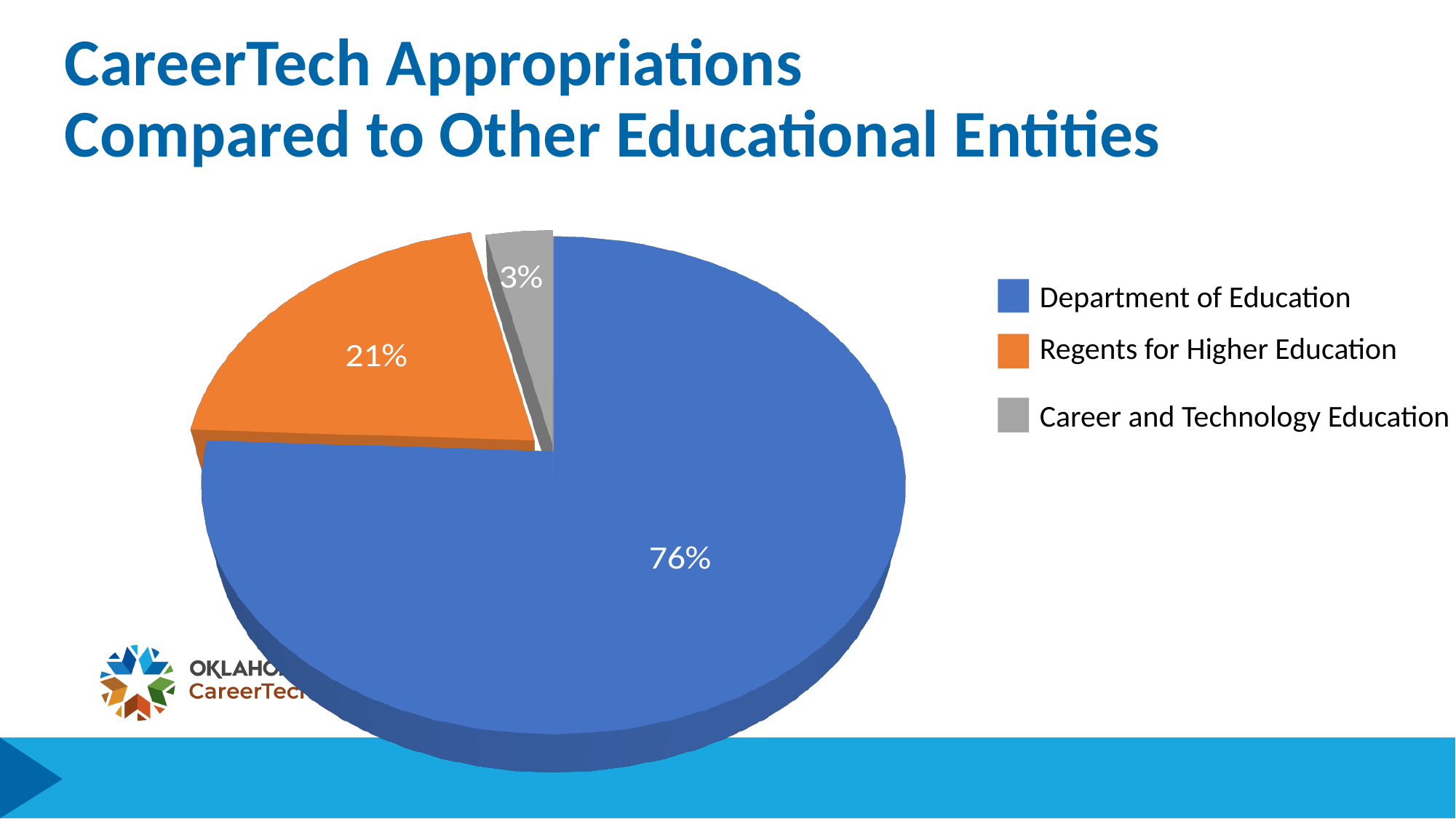
What colour is the slice for Career and Technology Education? gray What kind of chart is shown on the slide? pie chart What is the difference in percentage points between Regents for Higher Education and Career and Technology Education? 18 How many slices does the pie chart have? 3 What share of the pie does Career and Technology Education have? 3% What share of the pie does Regents for Higher Education have? 21% How many entries does the legend list? 3 Which category has the largest slice of the pie? Department of Education What share of the pie does Department of Education have? 76% Which category has the smallest slice of the pie? Career and Technology Education What is the difference in percentage points between Department of Education and Regents for Higher Education? 55 Which is larger, the share for Regents for Higher Education or the share for Career and Technology Education? Regents for Higher Education